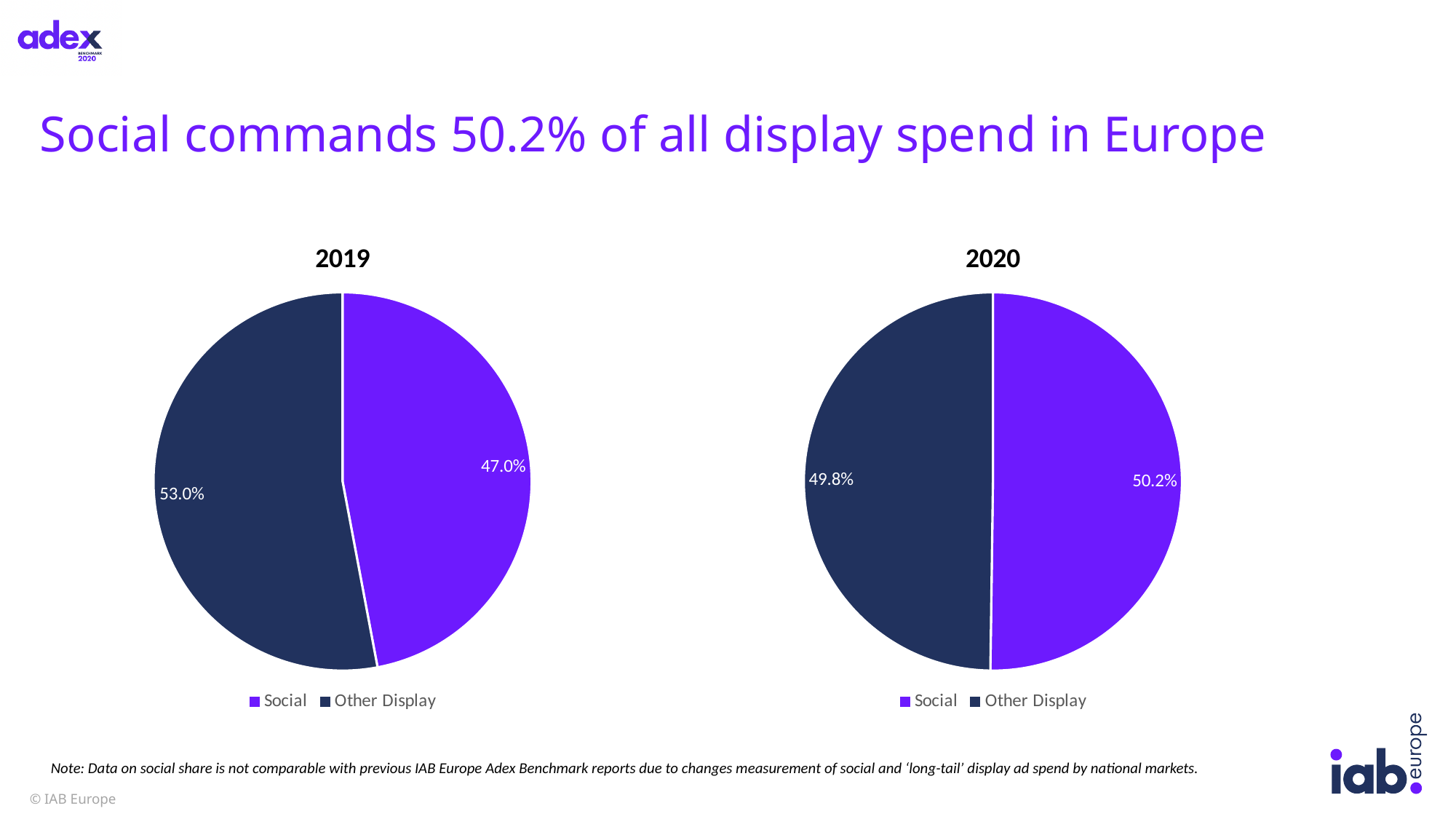
In the 2020 pie chart, what share does Social have? 50.2% How many slices does the 2019 pie chart have? 2 In the 2020 pie chart, what share does Other Display have? 49.8% Comparing the two charts, is the Social share larger in 2019 or in 2020? 2020 In the 2019 pie chart, what is the difference between the Other Display share and the Social share? 6.0% In the 2019 pie chart, what share does Social have? 47.0% In the 2020 pie chart, what is the difference between the Social share and the Other Display share? 0.4% What kind of chart is the 2020 chart? Pie chart In the 2019 pie chart, what share does Other Display have? 53.0% How many entries does the legend of the 2020 pie chart list? 2 In the 2019 pie chart, which slice is the largest? Other Display In the 2019 pie chart, what colour is the Social slice? Purple